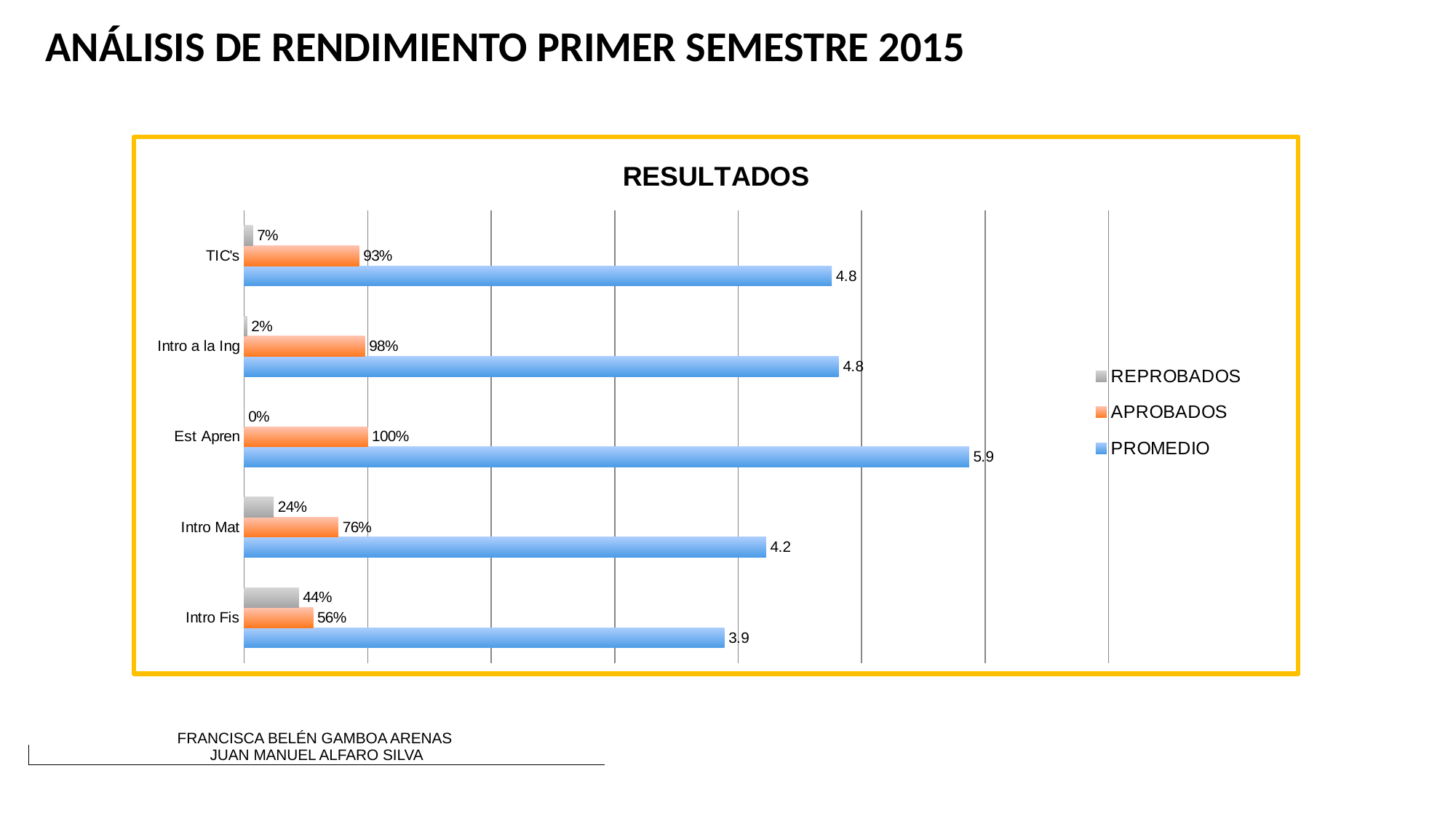
What is the APROBADOS value for TIC's? 93% What is the APROBADOS value for Intro Mat? 76% How many series does the legend list? 3 Which category has the lowest APROBADOS value? Intro Fis What is the title of the chart? RESULTADOS What is the difference between the APROBADOS values for Intro a la Ing and Intro Mat? 22% Which is larger, the REPROBADOS value for Intro Mat or for TIC's? Intro Mat What kind of chart is shown? bar chart What is the PROMEDIO value for Est Apren? 5.9 What is the REPROBADOS value for Intro Fis? 44% How many categories are shown on the chart? 5 Which category has the highest PROMEDIO value? Est Apren